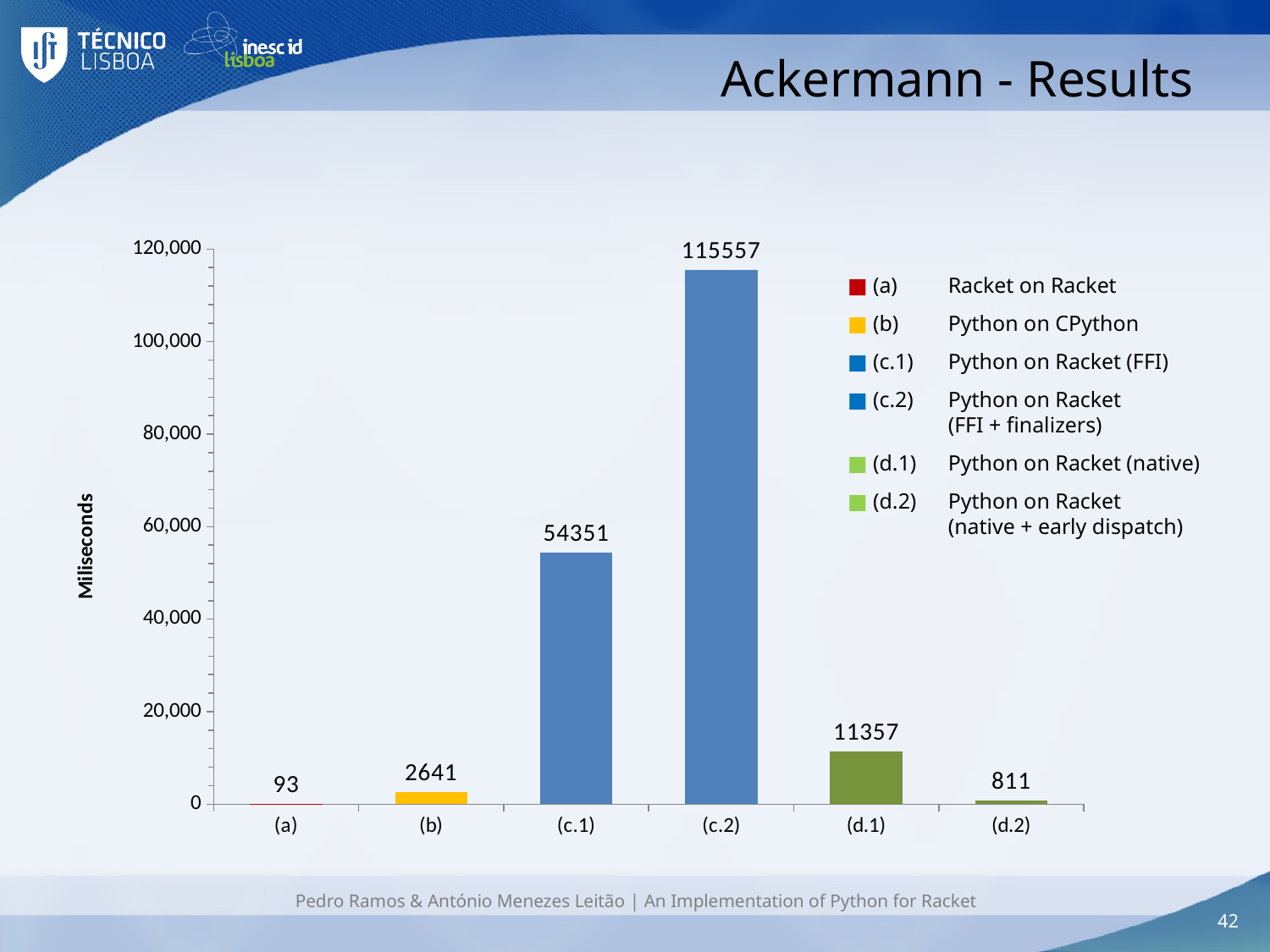
What is the difference between the values for (b) and (d.2)? 1830 What kind of chart is shown on the slide? bar chart What is the value for (d.1) in the Ackermann results chart? 11357 What is the value for (a) in the Ackermann results chart? 93 Which category has the lowest value in the Ackermann results chart? (a) What is the value for (c.2) in the Ackermann results chart? 115557 Which is larger, the value for (d.1) or the value for (b)? (d.1) Which category has the highest value in the Ackermann results chart? (c.2) How many categories are shown on the x axis of the chart? 6 According to the legend, what does (d.2) stand for? Python on Racket (native + early dispatch) Is the value for (c.1) greater or less than 60,000? less What is the difference between the values for (c.2) and (c.1)? 61206